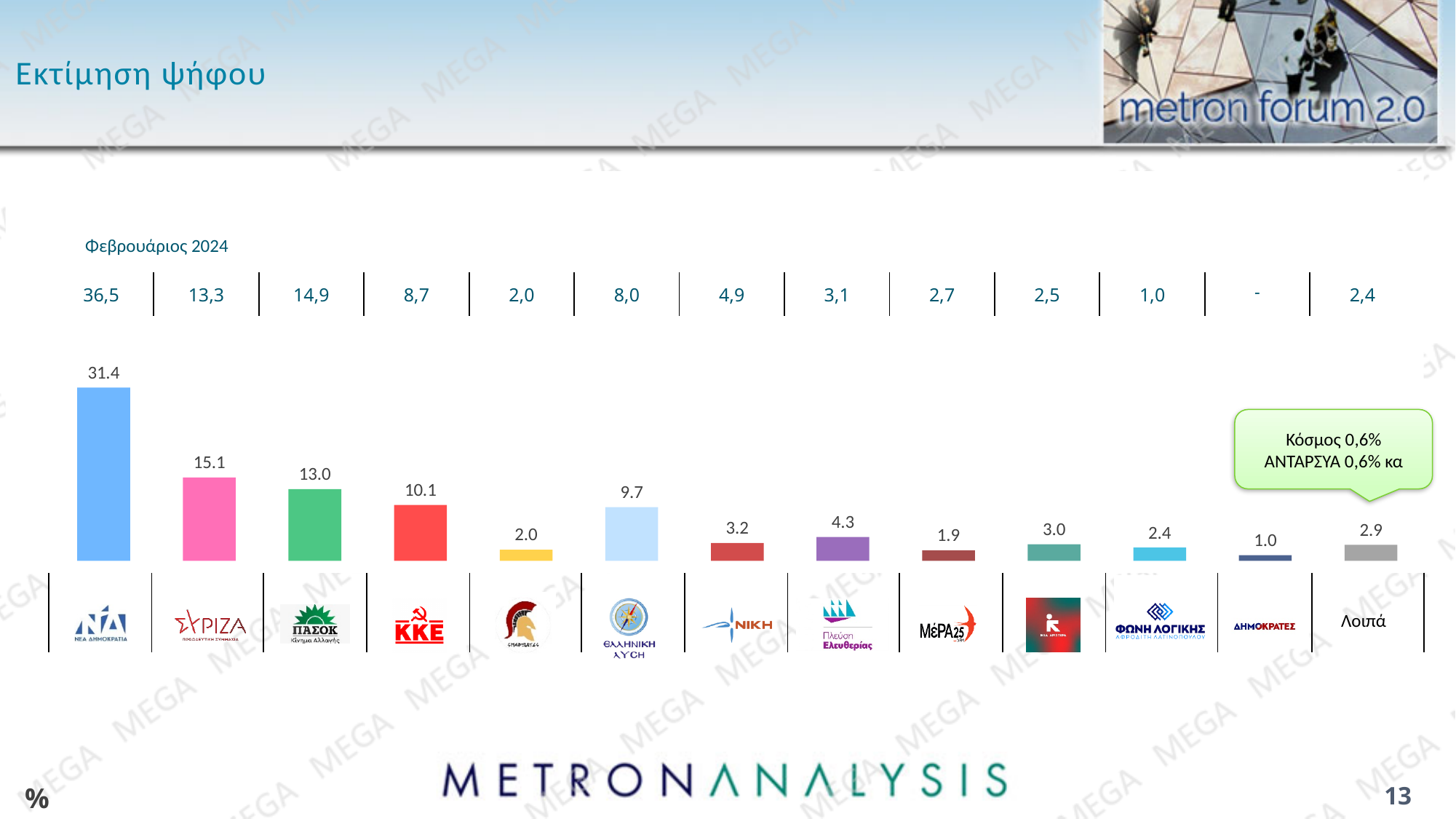
What is the difference between the bar values for ΝΕΑ ΔΗΜΟΚΡΑΤΙΑ and ΣΥΡΙΖΑ? 16.3 What is the value of the bar for ΚΚΕ? 10.1 What value is shown for ΝΕΑ ΔΗΜΟΚΡΑΤΙΑ in the Φεβρουάριος 2024 row above the chart? 36,5 How many bars (categories) are shown in the chart? 13 What is the value of the bar for Λοιπά? 2.9 Which party has the lowest bar in the chart? ΔΗΜΟΚΡΑΤΕΣ What is the value of the bar for Ελληνική Λύση? 9.7 What is the value of the bar for ΝΕΑ ΔΗΜΟΚΡΑΤΙΑ? 31.4 Which party has the highest bar in the chart? ΝΕΑ ΔΗΜΟΚΡΑΤΙΑ What is the value of the bar for ΣΥΡΙΖΑ? 15.1 What kind of chart is shown on the slide? bar chart Which bar is larger, ΠΑΣΟΚ or ΚΚΕ? ΠΑΣΟΚ